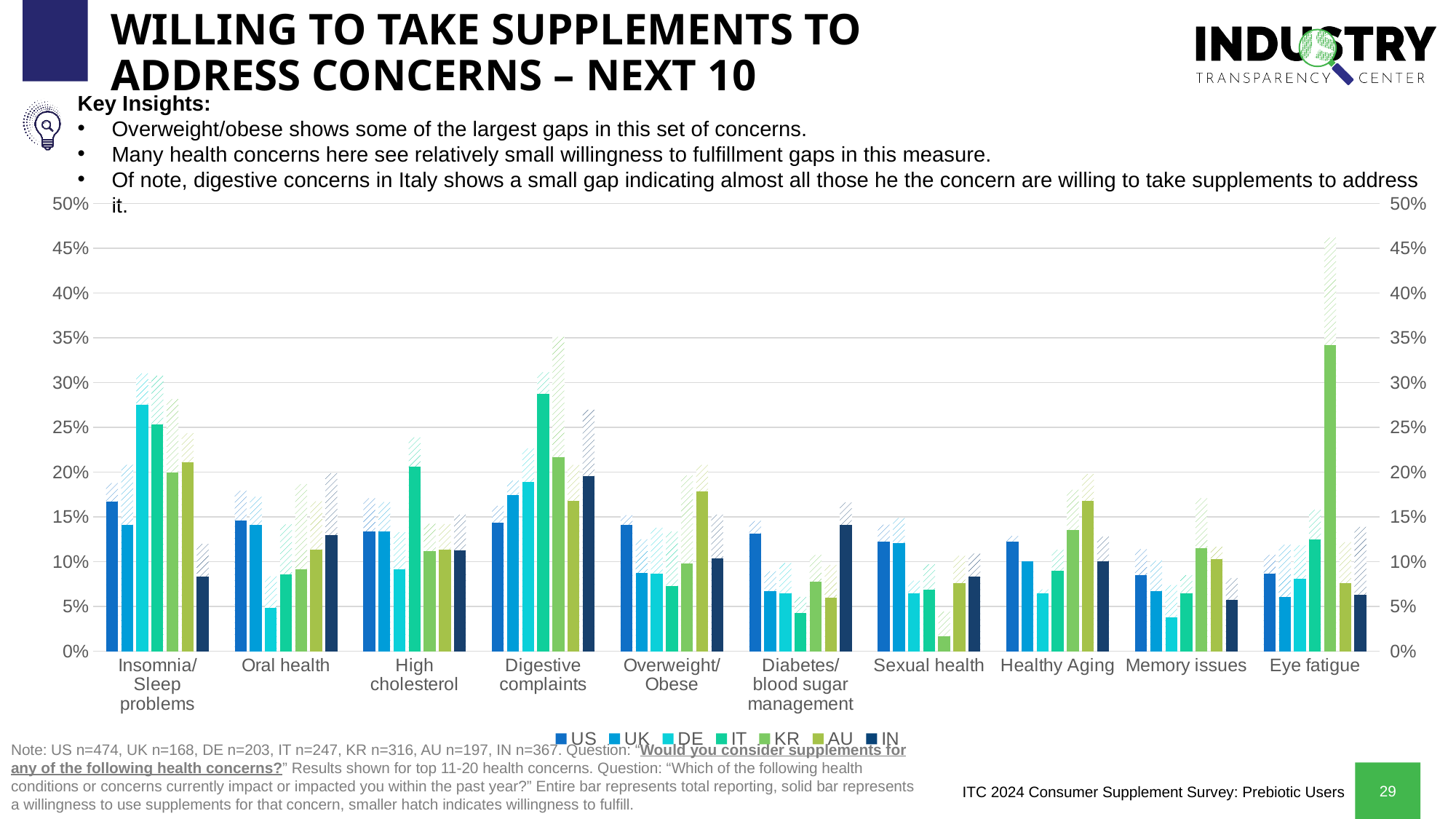
Is the solid DE value for Memory issues greater or less than 5%? less How many series does the legend list? 7 How many health concern categories are shown on the x axis? 10 Which series has the shortest solid bar for Sexual health? KR Is the solid IT value for Digestive complaints greater or less than 25%? greater Which series has the tallest solid bar for Eye fatigue? KR For Overweight/Obese, which solid bar is taller, AU or US? AU What kind of chart is shown on the slide? bar chart For Digestive complaints, which solid bar is taller, IT or AU? IT Is the solid KR value for Eye fatigue greater or less than 30%? greater Which series is listed last in the legend? IN